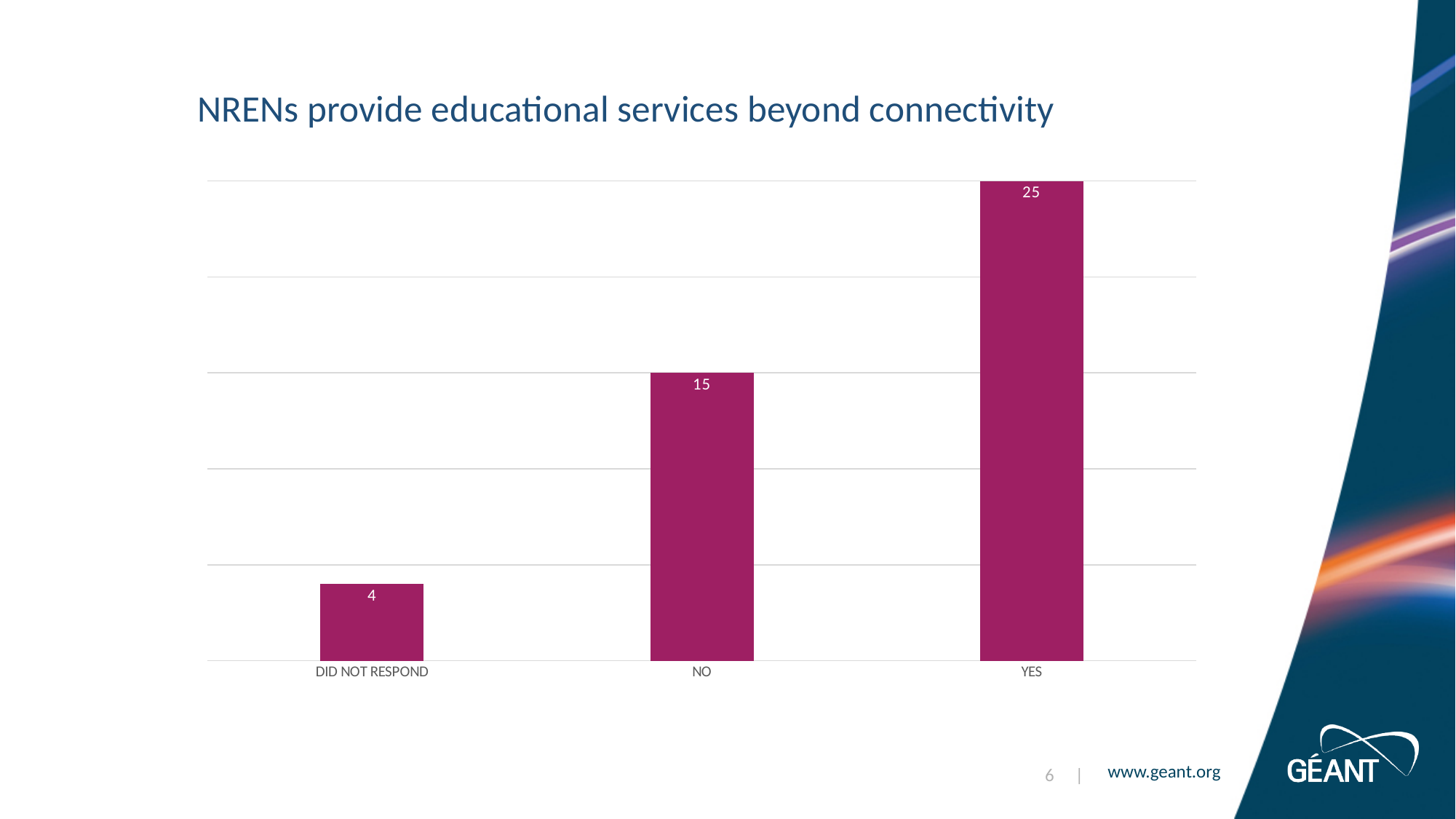
What is the value for YES? 25 What is the value for NO? 15 Which is larger, the value for NO or the value for DID NOT RESPOND? NO What is the difference between the values for YES and NO? 10 What is the title of the slide? NRENs provide educational services beyond connectivity What is the difference between the values for NO and DID NOT RESPOND? 11 Do the values rise or fall from left to right along the x axis? Rise Which category has the lowest value? DID NOT RESPOND What is the value for DID NOT RESPOND? 4 How many categories are shown on the x axis? 3 What kind of chart is shown on the slide? Bar chart Which category has the highest value? YES